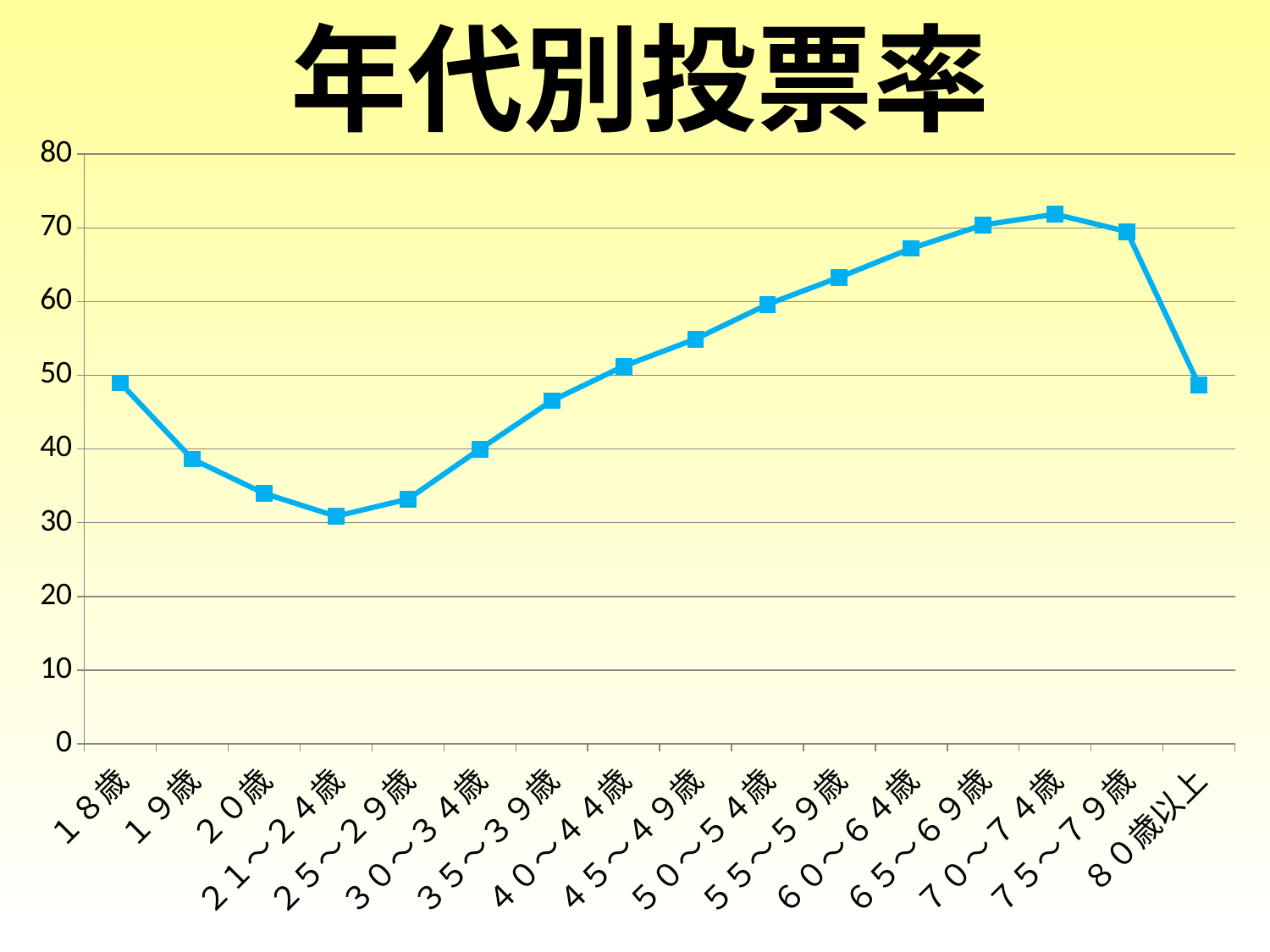
Is the value for 60～64歳 greater or less than 60? greater Is the value for 45～49歳 greater or less than 50? greater How many age categories are plotted along the x axis? 16 Is the value for 19歳 greater or less than 40? less What is the title of the chart? 年代別投票率 What kind of chart is shown on the slide? line chart Which has the larger value, 18歳 or 19歳? 18歳 Do the values rise or fall from 21～24歳 to 70～74歳? rise Which age category has the lowest value? 21～24歳 Which age category has the highest value? 70～74歳 Which has the larger value, 30～34歳 or 65～69歳? 65～69歳